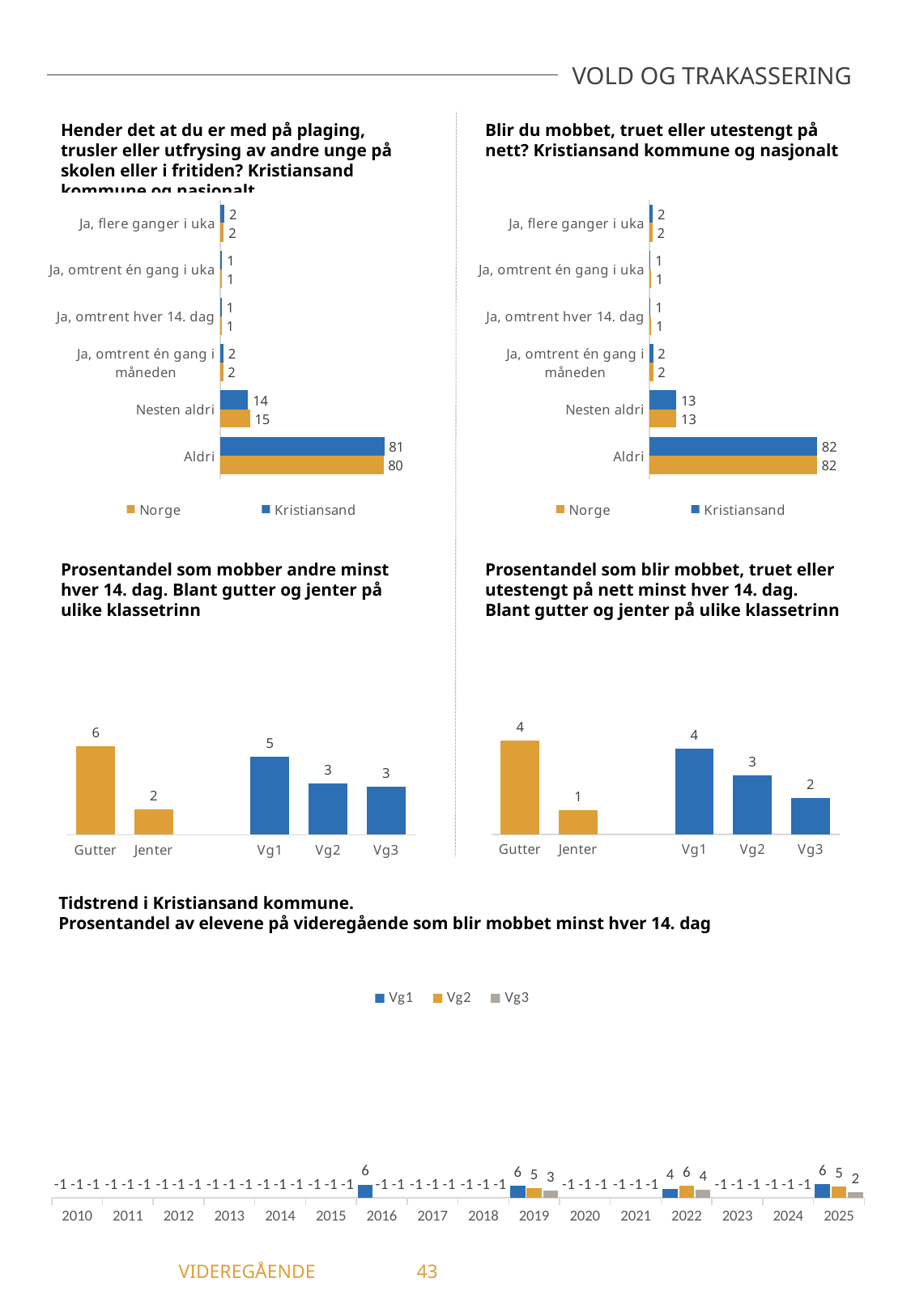
In the chart 'Prosentandel som blir mobbet, truet eller utestengt på nett minst hver 14. dag', which category has the lowest value? Jenter In the chart 'Blir du mobbet, truet eller utestengt på nett?', what is the value for Kristiansand in the 'Aldri' category? 82 In the chart 'Hender det at du er med på plaging, trusler eller utfrysing av andre unge på skolen eller i fritiden?', what is the value for Kristiansand in the 'Nesten aldri' category? 14 In the chart 'Blir du mobbet, truet eller utestengt på nett?', how many series does the legend list? 2 In the chart 'Tidstrend i Kristiansand kommune', which is larger in 2025: Vg1 or Vg3? Vg1 What kind of chart is the 'Tidstrend i Kristiansand kommune' chart at the bottom of the slide? bar chart In the chart 'Prosentandel som mobber andre minst hver 14. dag', which category has the highest value? Gutter In the chart 'Prosentandel som blir mobbet, truet eller utestengt på nett minst hver 14. dag', do the values rise or fall from Vg1 to Vg3? fall In the chart 'Hender det at du er med på plaging, trusler eller utfrysing av andre unge på skolen eller i fritiden?', what is the value for Norge in the 'Aldri' category? 80 In the chart 'Tidstrend i Kristiansand kommune', what is the value for Vg2 in 2022? 6 In the chart 'Prosentandel som mobber andre minst hver 14. dag', what is the value for Vg1? 5 In the chart 'Prosentandel som mobber andre minst hver 14. dag', what is the difference between the values for Gutter and Jenter? 4